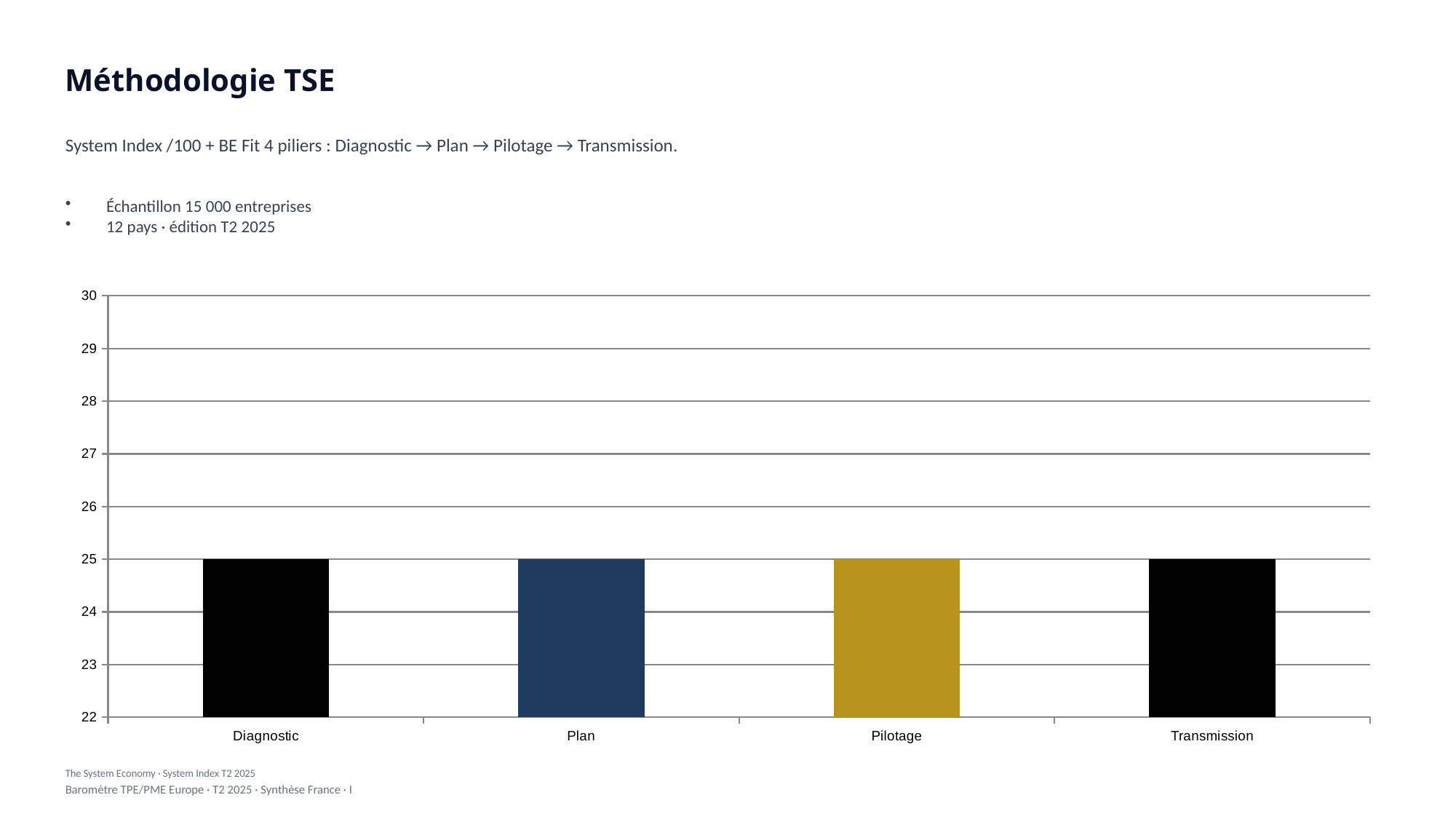
What is the value for Diagnostic? 25 Is the value for Transmission greater or less than 28? less What kind of chart is shown on the slide? bar chart How many categories are shown on the x axis of the chart? 4 What is the value for Plan? 25 What is the value for Pilotage? 25 What is the label of the first category on the x axis? Diagnostic What is the difference between the values for Diagnostic and Plan? 0 Do the values rise, fall or stay flat from Diagnostic to Transmission? stay flat What is the value for Transmission? 25 Is the value for Pilotage greater or less than 24? greater What is the highest value shown on the y axis? 30